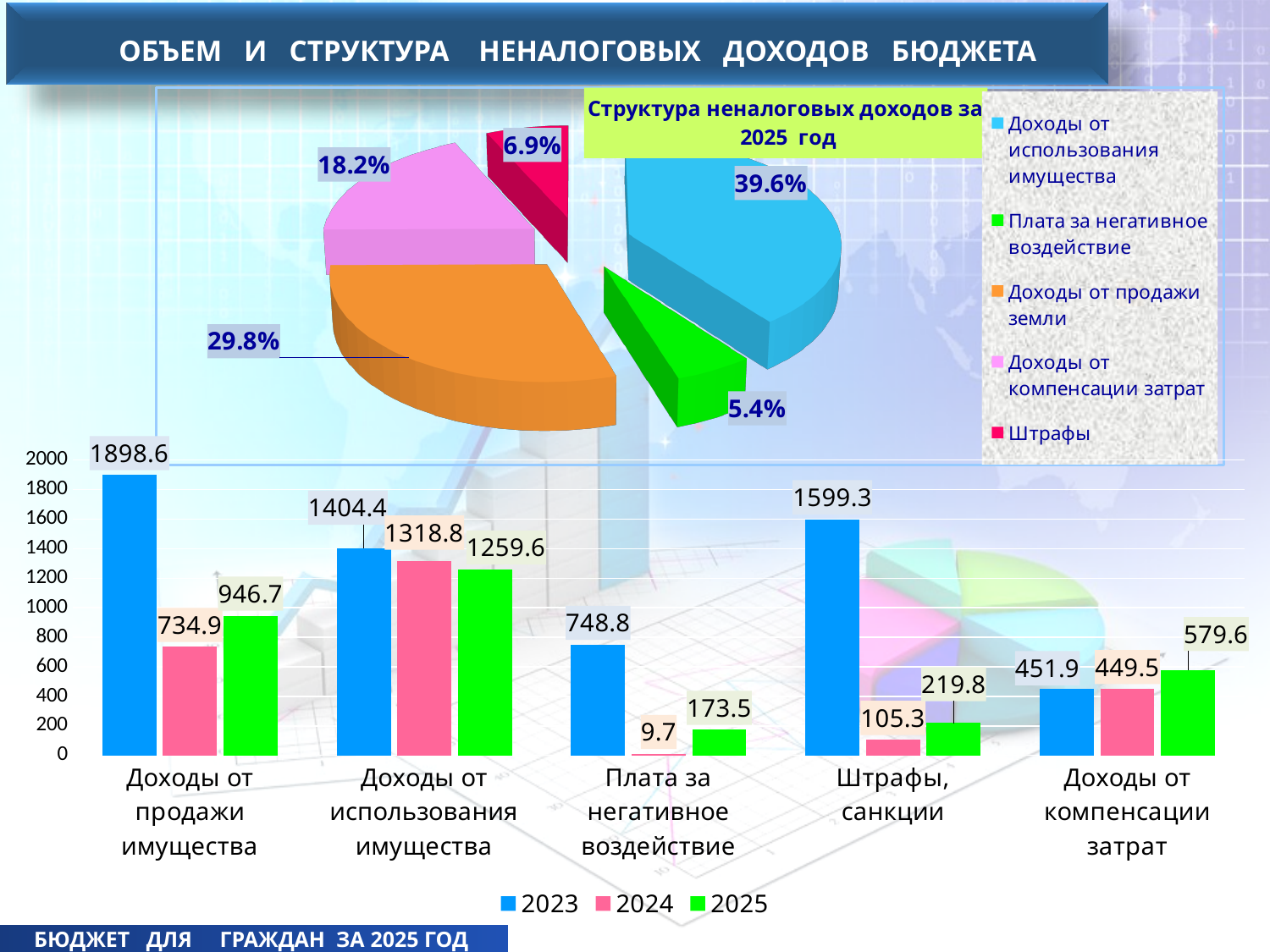
On the pie chart 'Структура неналоговых доходов за 2025 год', which category has the smallest share? Плата за негативное воздействие On the bar chart at the bottom of the slide, what is the difference between the 2023 and 2025 values for 'Штрафы, санкции'? 1379.5 On the bar chart at the bottom of the slide, do the values for 'Доходы от использования имущества' rise or fall from 2023 to 2025? Fall What kind of chart is shown at the bottom of the slide? Bar chart On the bar chart at the bottom of the slide, which category has the highest 2025 value? Доходы от использования имущества On the bar chart at the bottom of the slide, what is the value for 'Доходы от продажи имущества' in 2023? 1898.6 How many categories does the legend of the pie chart 'Структура неналоговых доходов за 2025 год' list? 5 On the pie chart 'Структура неналоговых доходов за 2025 год', what share is shown for 'Штрафы'? 6.9% On the bar chart at the bottom of the slide, how many series does the legend list? 3 On the bar chart at the bottom of the slide, what is the value for 'Плата за негативное воздействие' in 2024? 9.7 On the bar chart at the bottom of the slide, which is larger for 'Доходы от компенсации затрат': the 2023 value or the 2025 value? 2025 On the pie chart 'Структура неналоговых доходов за 2025 год', what share is shown for 'Доходы от использования имущества'? 39.6%